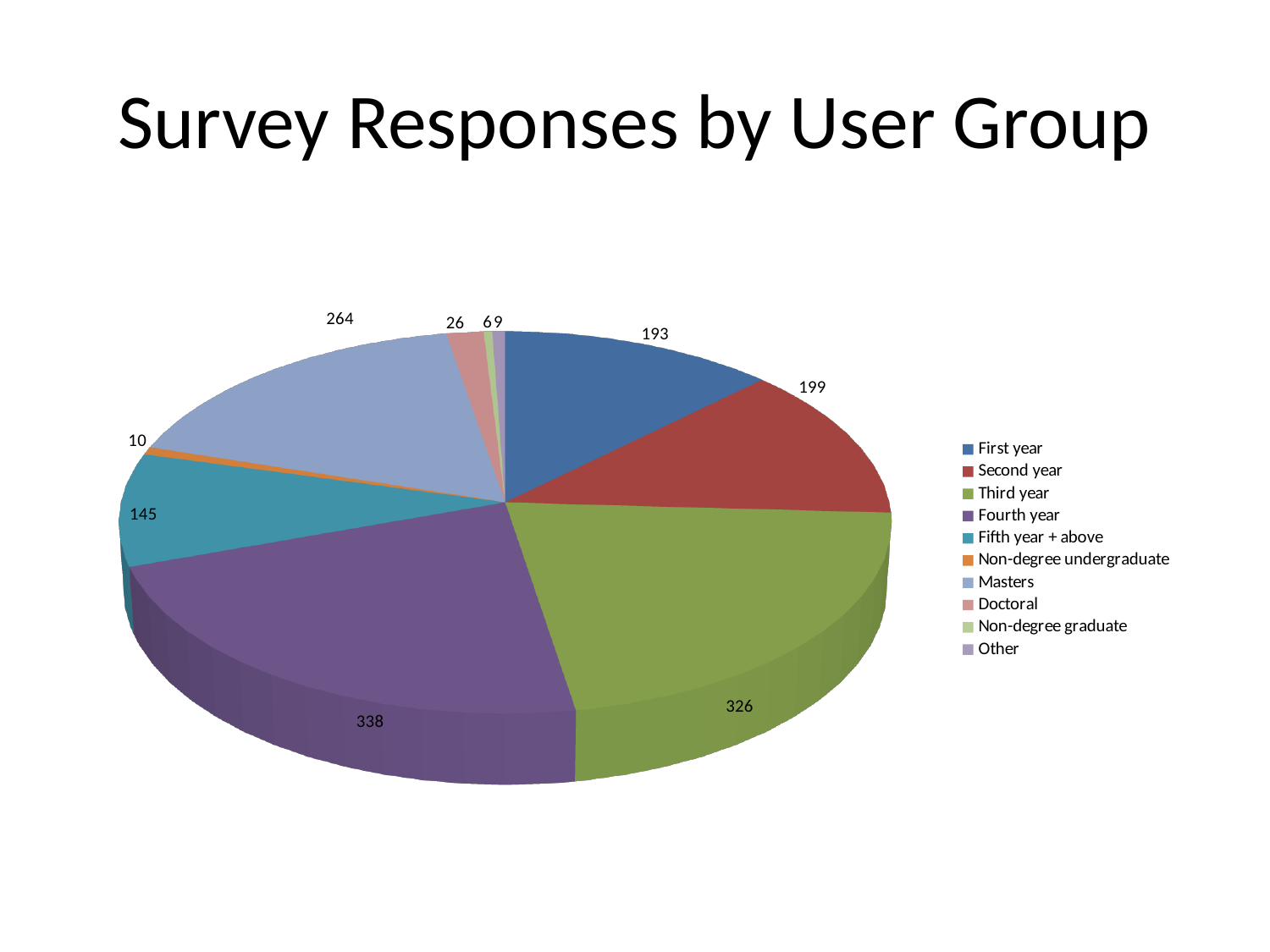
What is the difference between the Masters and Doctoral values? 238 What is the value for the Doctoral group? 26 How many user groups are shown in the pie chart? 10 What is the title of the chart? Survey Responses by User Group What kind of chart is shown on the slide? Pie chart Which user group has the highest number of responses? Fourth year What is the value for Fifth year + above? 145 What is the value for the Masters group? 264 How many survey responses came from the First year group? 193 Which is larger, the Second year value or the First year value? Second year Which user group has the lowest number of responses? Non-degree graduate What is the difference between the Fourth year and Third year values? 12